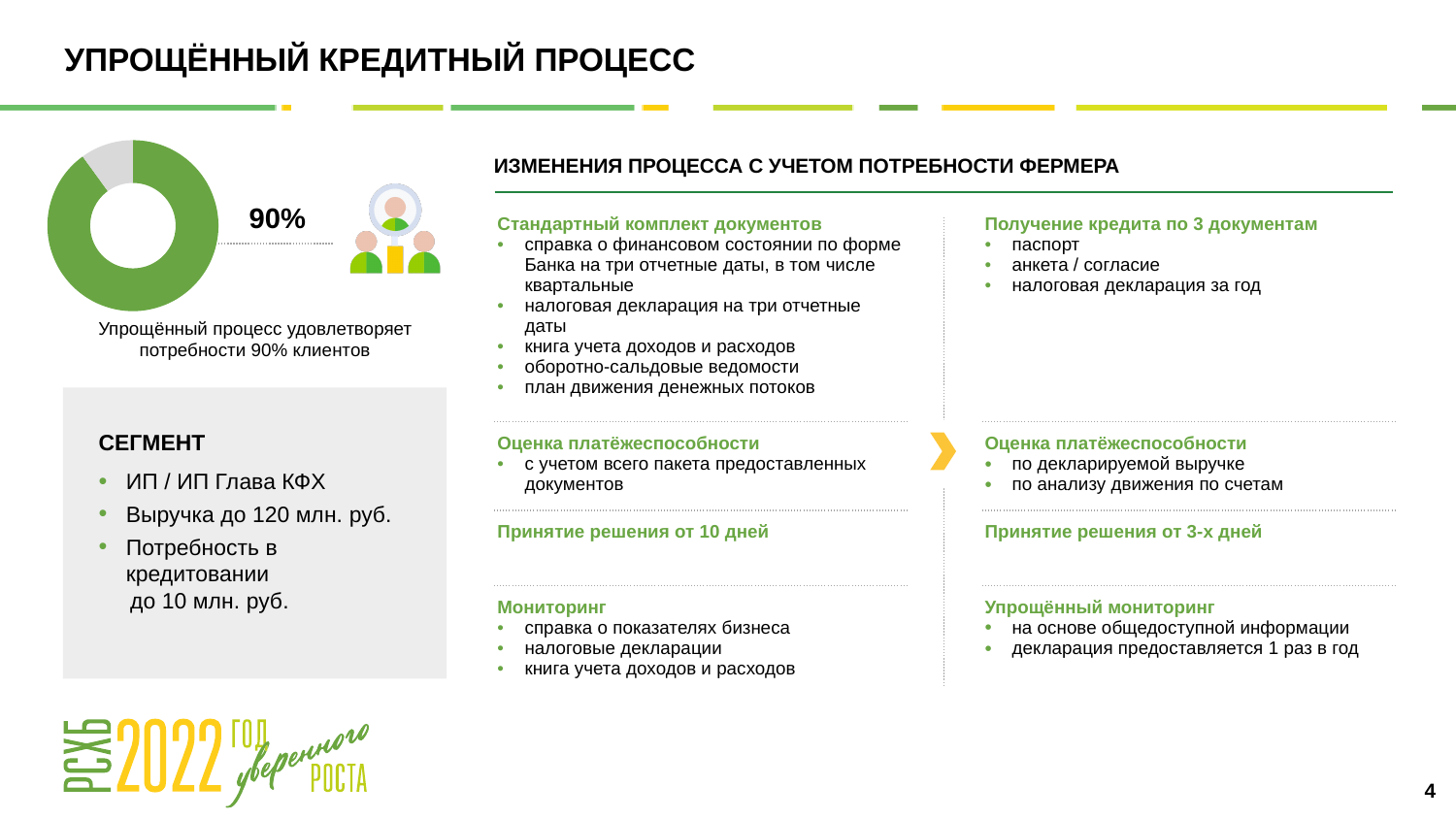
How many segments does the doughnut chart have? 2 Which segment of the doughnut chart is the smallest? The grey segment According to the caption under the doughnut chart, what percentage of clients' needs does the simplified process satisfy? 90% Is the value of the green segment in the doughnut chart greater or less than 50%? greater What share of the doughnut chart does the green segment represent? 90% What colour is the segment labelled 90% in the doughnut chart? Green What value is labelled on the green segment of the doughnut chart? 90% What kind of chart is shown on the left of the slide? Doughnut (pie) chart Which segment of the doughnut chart is larger, the green one or the grey one? Green